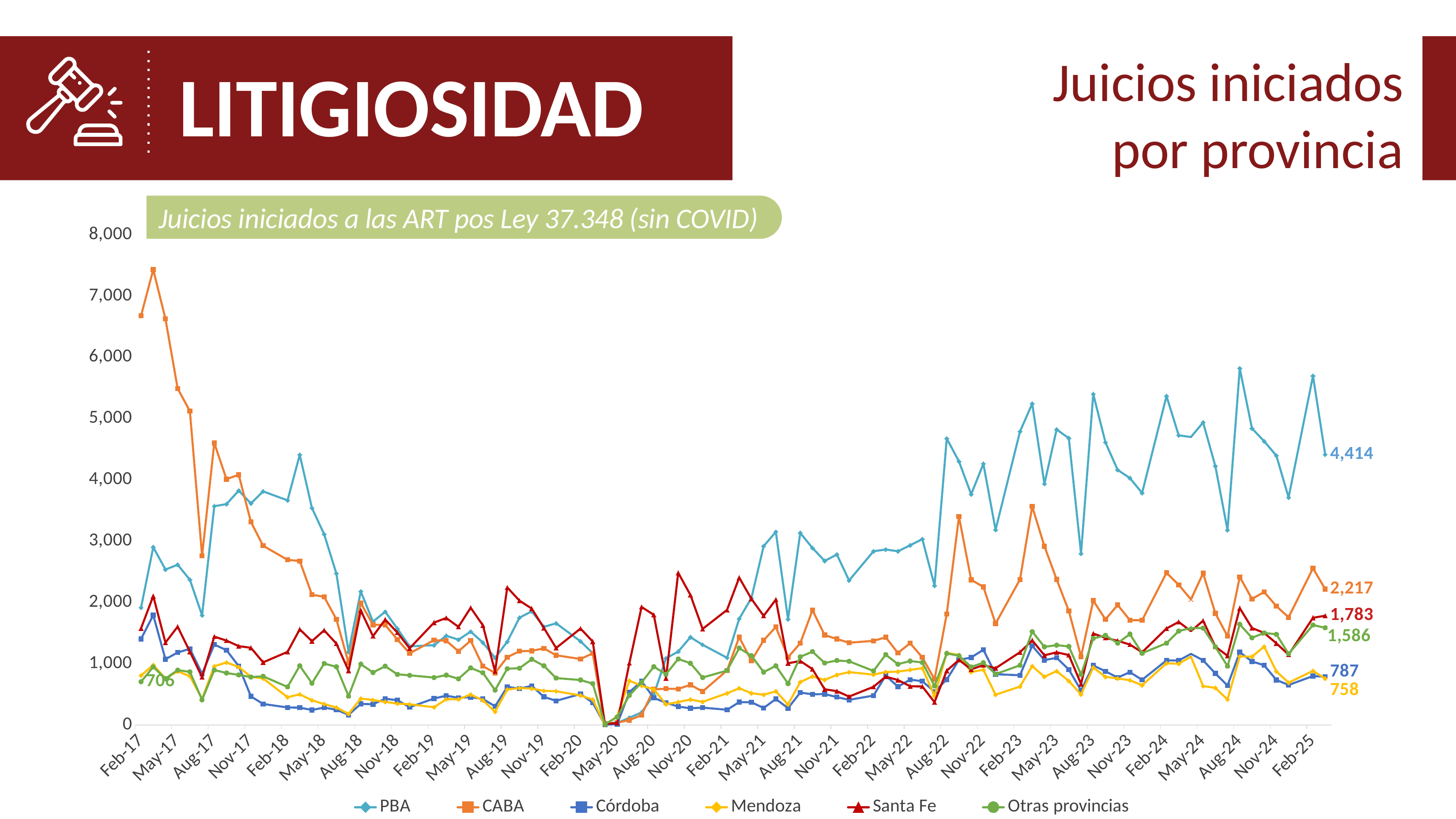
Which series has the highest final labelled value? PBA Is the value for CABA at Feb-17 greater or less than 6,000? greater What is the last labelled value for the Santa Fe series? 1,783 How many series does the legend list? 6 What is the labelled value for Otras provincias at Feb-17? 706 What is the last labelled value for the CABA series? 2,217 What is the difference between the final labelled values of Córdoba (787) and Mendoza (758)? 29 At the end of the series, which is larger: Santa Fe or Otras provincias? Santa Fe What is the last labelled value for the PBA series? 4,414 Which series has the lowest final labelled value? Mendoza What is the difference between the final labelled values of PBA (4,414) and CABA (2,217)? 2,197 What kind of chart is shown on the slide? Line chart